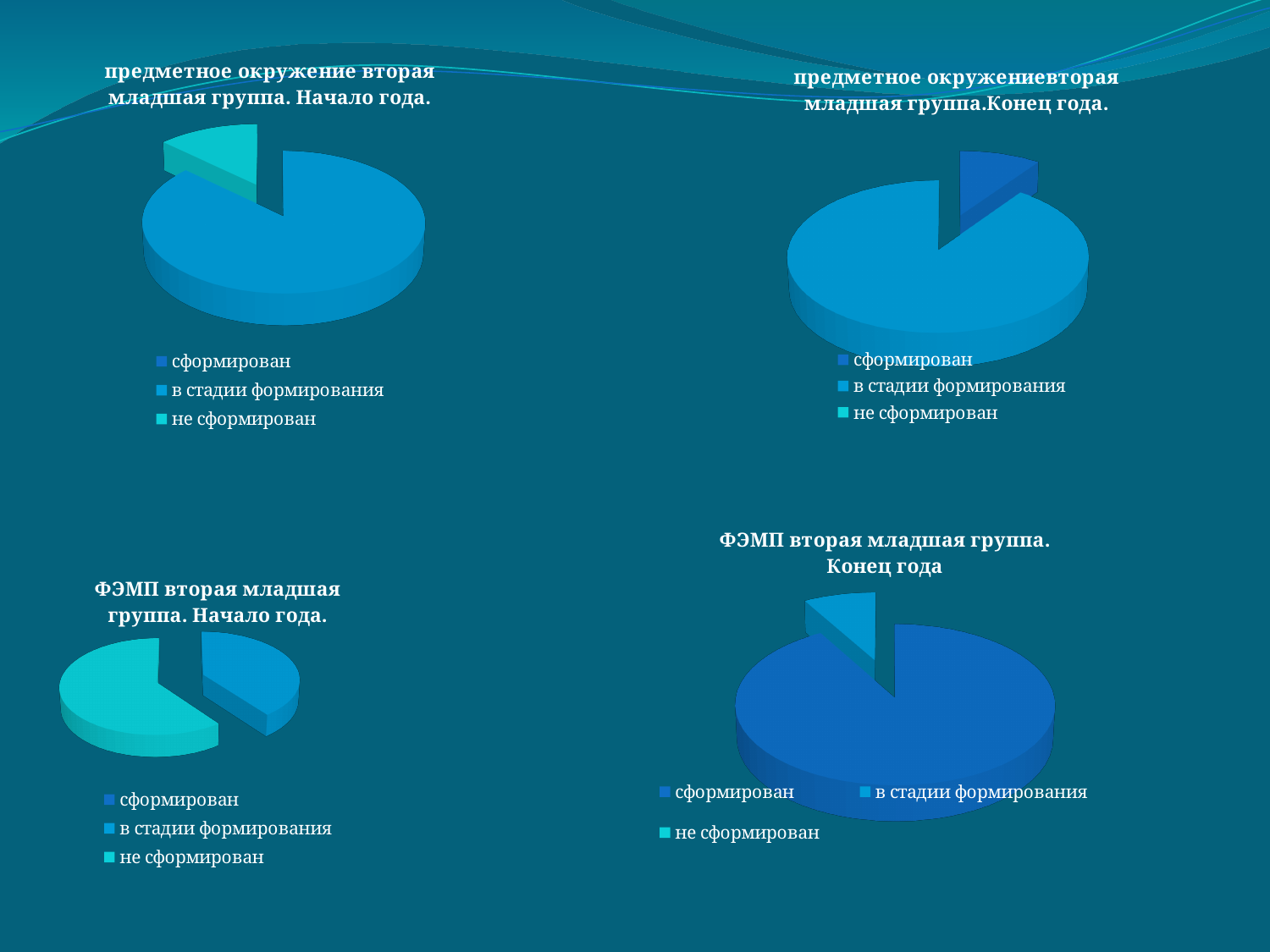
What is the title of the bottom-right chart? ФЭМП вторая младшая группа. Конец года What are the three legend entries of the bottom-left chart ("ФЭМП вторая младшая группа. Начало года.")? сформирован, в стадии формирования, не сформирован In the bottom-left chart ("ФЭМП вторая младшая группа. Начало года."), which category has the largest slice? не сформирован How many pie charts are shown on the slide? 4 In the top-left chart ("предметное окружение вторая младшая группа. Начало года."), which category has the largest slice? в стадии формирования How many entries does the legend of the top-left chart ("предметное окружение вторая младшая группа. Начало года.") list? 3 In the bottom-right chart ("ФЭМП вторая младшая группа. Конец года"), which slice is larger: "сформирован" or "в стадии формирования"? сформирован In the bottom-left chart ("ФЭМП вторая младшая группа. Начало года."), which slice is larger: "не сформирован" or "в стадии формирования"? не сформирован In the top-right chart ("предметное окружениевторая младшая группа.Конец года."), which slice is larger: "сформирован" or "в стадии формирования"? в стадии формирования What kind of chart is the top-left chart titled "предметное окружение вторая младшая группа. Начало года."? pie chart In the bottom-right chart ("ФЭМП вторая младшая группа. Конец года"), which category has the largest slice? сформирован